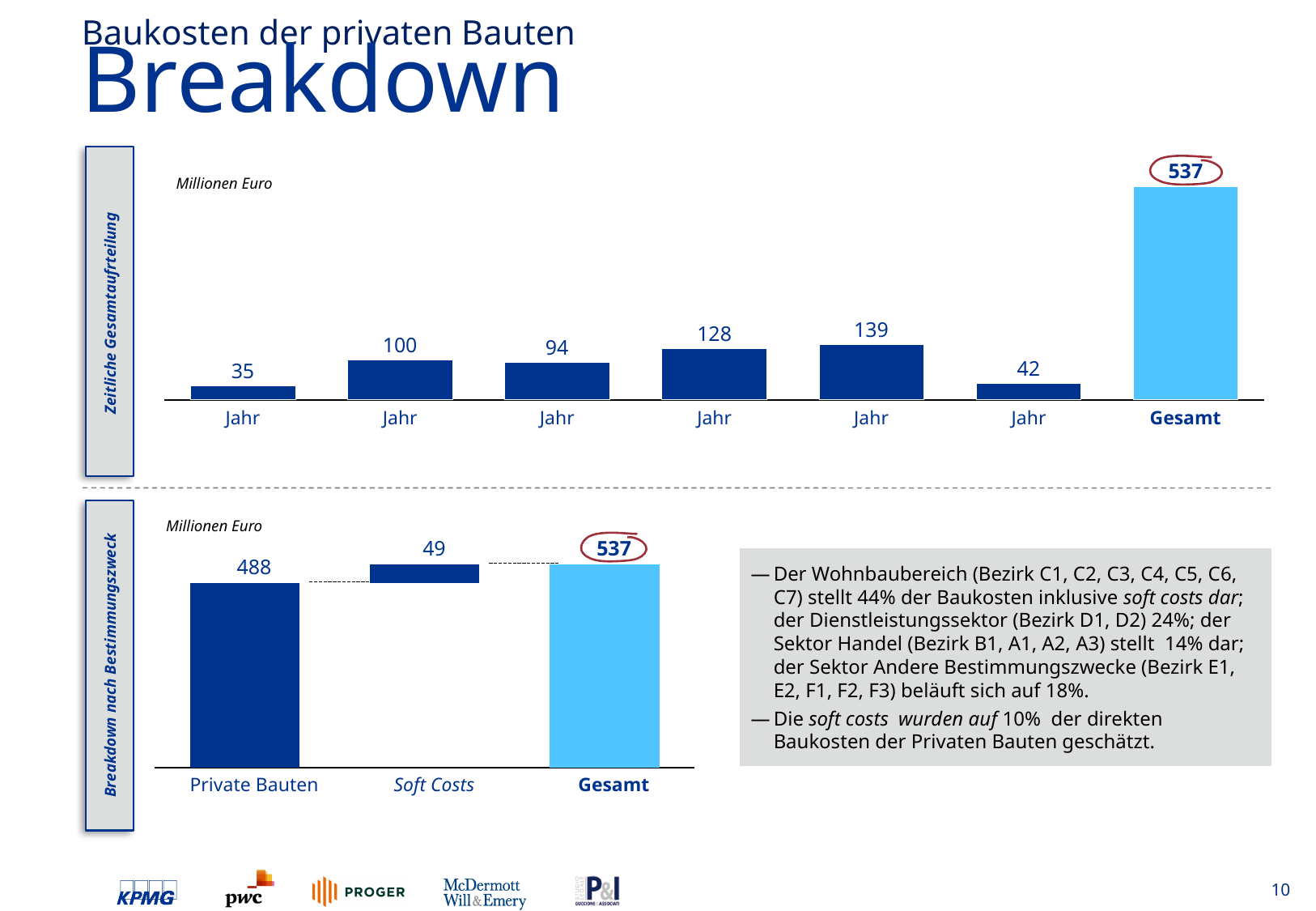
What kind of chart is the bottom chart (Breakdown nach Bestimmungszweck)? Bar chart In the bottom chart (Breakdown nach Bestimmungszweck), what is the value for Private Bauten? 488 In the top chart (Zeitliche Gesamtaufrteilung), what is the value of the Gesamt bar? 537 In the bottom chart (Breakdown nach Bestimmungszweck), which is larger, Private Bauten or Soft Costs? Private Bauten In the top chart (Zeitliche Gesamtaufrteilung), which of the Jahr bars has the highest value? The fifth Jahr bar (139) In the bottom chart (Breakdown nach Bestimmungszweck), what is the value for Soft Costs? 49 In the top chart (Zeitliche Gesamtaufrteilung), what is the value of the fifth Jahr bar? 139 In the top chart (Zeitliche Gesamtaufrteilung), how many bars are plotted in total, including Gesamt? 7 In the top chart (Zeitliche Gesamtaufrteilung), which of the Jahr bars has the lowest value? The first Jahr bar (35) In the bottom chart (Breakdown nach Bestimmungszweck), what is the difference between Private Bauten and Soft Costs? 439 In the top chart (Zeitliche Gesamtaufrteilung), what is the difference between the fourth Jahr bar and the third Jahr bar? 34 In the top chart (Zeitliche Gesamtaufrteilung), what is the value of the first Jahr bar on the left? 35